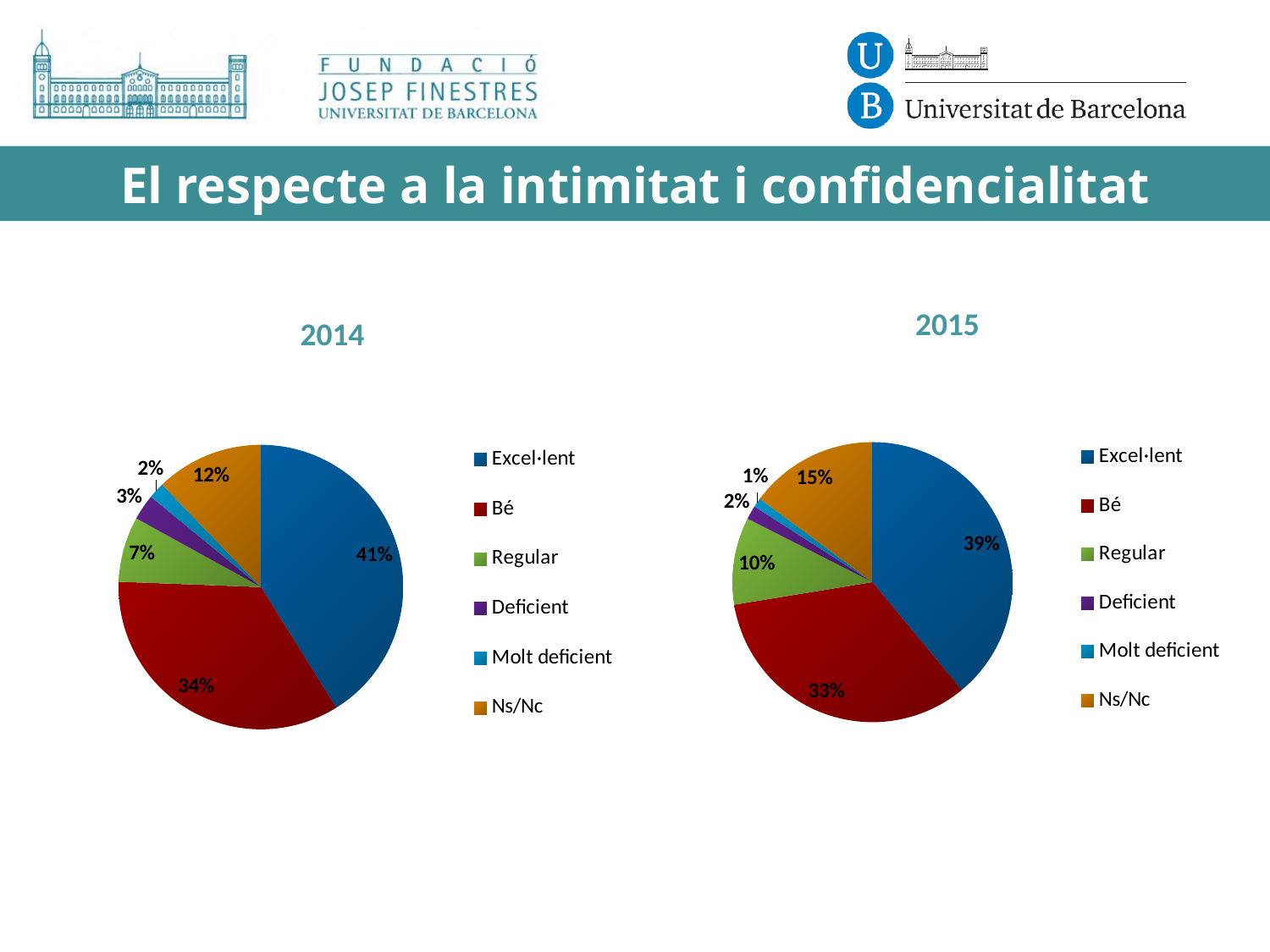
In the 2014 pie chart, what percentage is shown for Regular? 7% How many categories does the legend of the 2015 pie chart list? 6 Which is larger: the Regular share in 2014 or the Regular share in 2015? 2015 In the 2015 pie chart, what percentage is shown for Ns/Nc? 15% In the 2015 pie chart, which category has the smallest share? Molt deficient In the 2015 pie chart, what is the combined share of Excel·lent and Bé? 72% In the 2014 pie chart, which category has the largest share? Excel·lent What is the difference between the Excel·lent share in 2014 and in 2015? 2% In the 2014 pie chart, what percentage is shown for Excel·lent? 41% In the 2014 pie chart, which colour represents Ns/Nc? Orange What type of chart is used for the 2014 data? Pie chart In the 2015 pie chart, what percentage is shown for Bé? 33%